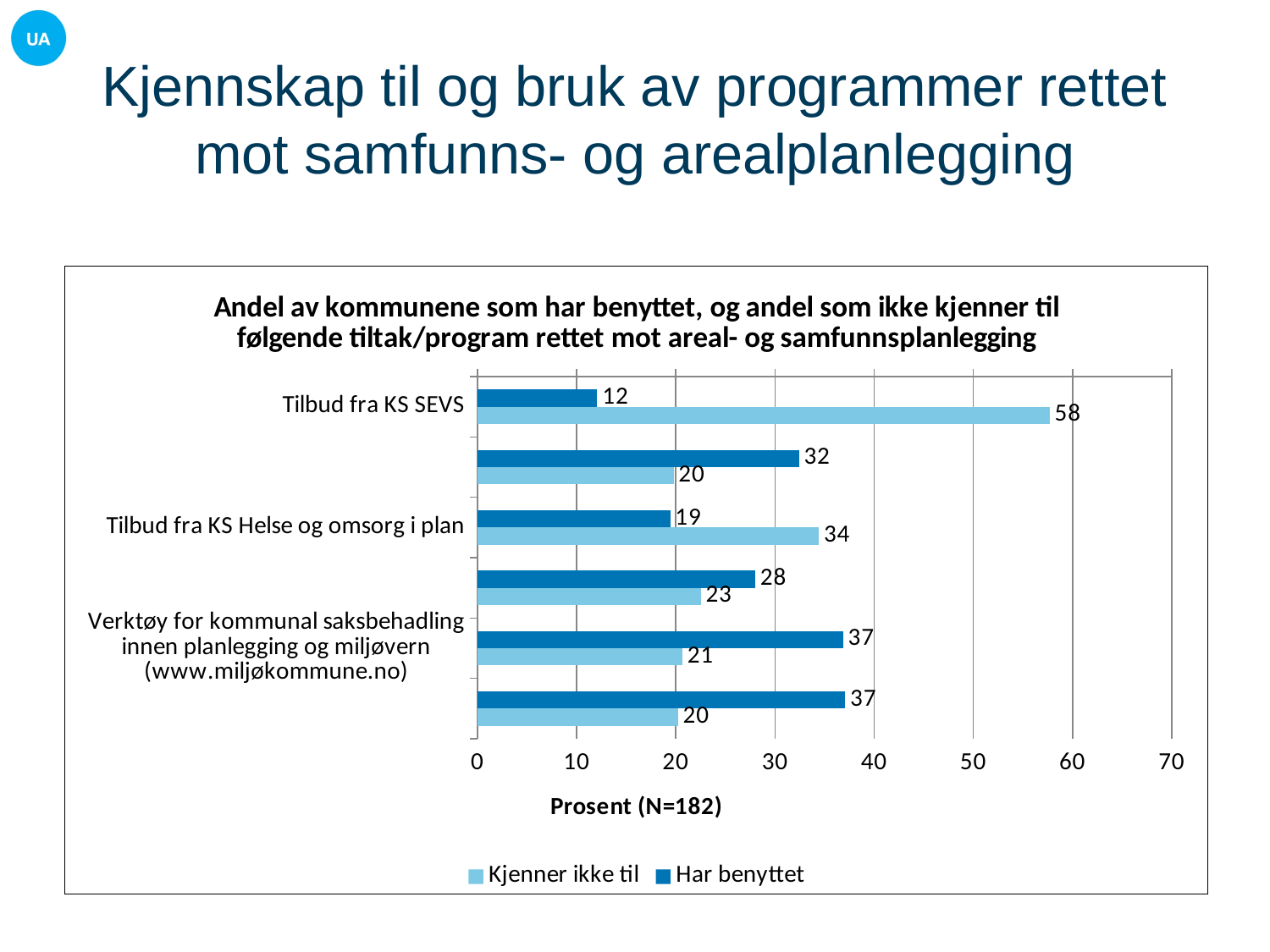
What is the 'Har benyttet' value for Tilbud fra KS SEVS? 12 Which category has the lowest 'Har benyttet' value? Tilbud fra KS SEVS What is the 'Har benyttet' value for Tilbud fra KS Helse og omsorg i plan? 19 What kind of chart is shown on the slide? bar chart Which category has the highest 'Kjenner ikke til' value? Tilbud fra KS SEVS For Verktøy for kommunal saksbehadling innen planlegging og miljøvern, which is larger: 'Har benyttet' or 'Kjenner ikke til'? Har benyttet How many series does the legend list? 2 How many categories (pairs of bars) are plotted in the chart? 6 What is the difference between the 'Kjenner ikke til' and 'Har benyttet' values for Tilbud fra KS SEVS? 46 What is the 'Kjenner ikke til' value for Verktøy for kommunal saksbehadling innen planlegging og miljøvern (www.miljøkommune.no)? 21 What is the 'Kjenner ikke til' value for Tilbud fra KS SEVS? 58 What is the title of the horizontal axis? Prosent (N=182)